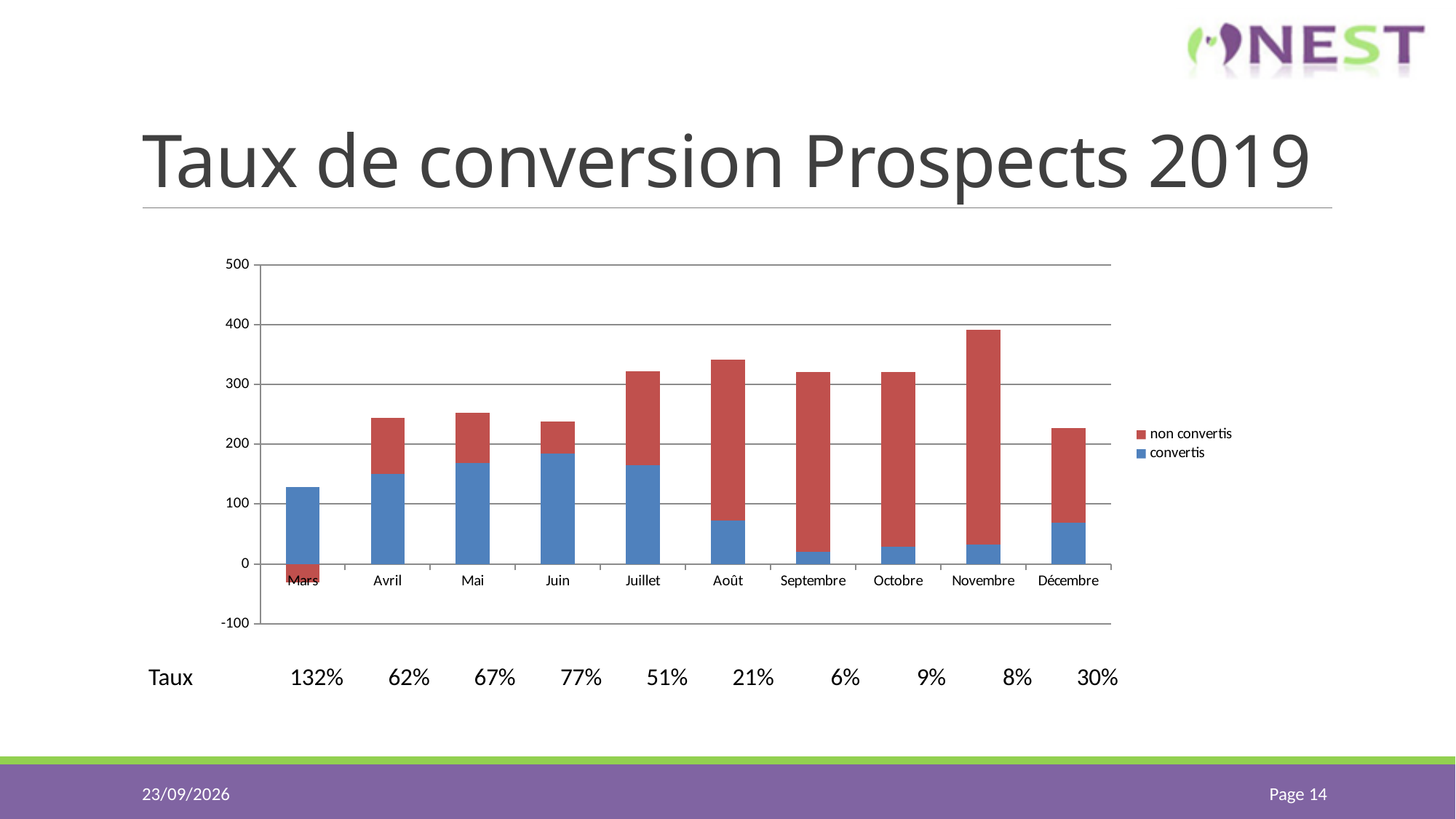
How many series does the chart legend list? 2 Is the total bar height for Novembre greater or less than 300? greater Is the 'convertis' value for Septembre greater or less than 100? less What kind of chart is shown on the slide? Stacked bar chart Which has the larger 'convertis' segment, Avril or Août? Avril Which month has the taller stacked bar, Août or Novembre? Novembre How many months are shown on the x axis of the chart? 10 Which month has the tallest stacked bar in the chart? Novembre Is the 'convertis' value for Mars greater or less than 100? greater Which two series are listed in the chart legend? non convertis and convertis Which month has the largest 'convertis' (blue) segment? Juin According to the 'Taux' row under the chart, what is the conversion rate for Juin? 77%